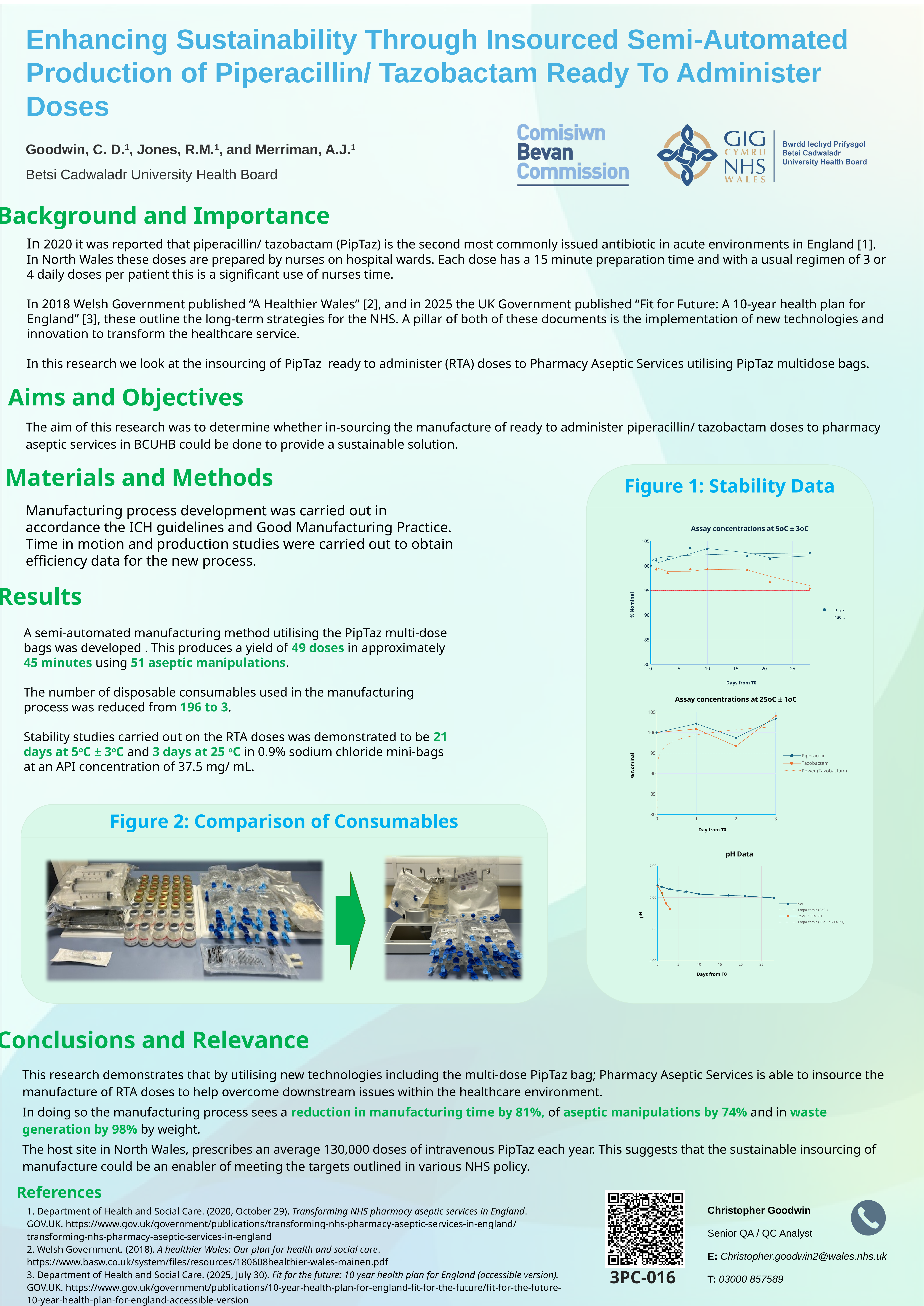
In the 'pH Data' chart, does the 5oC series rise or fall across the days from T0? fall In the 'Assay concentrations at 25oC ± 1oC' chart, how many days are plotted on the x axis? 4 In the 'Assay concentrations at 25oC ± 1oC' chart, how many entries does the legend list? 3 In the 'Assay concentrations at 5oC ± 3oC' chart, which series is higher at day 28, Piperacillin or Tazobactam? Piperacillin In the 'Assay concentrations at 5oC ± 3oC' chart, is the Piperacillin value at day 10 greater or less than 100? greater In the 'Assay concentrations at 5oC ± 3oC' chart, does the Tazobactam series rise or fall from day 0 to day 28? fall In the 'Assay concentrations at 5oC ± 3oC' chart, is the Tazobactam value at day 28 greater or less than 100? less In the 'Assay concentrations at 25oC ± 1oC' chart, is the Piperacillin value at day 3 greater or less than 100? greater In the 'pH Data' chart, how many entries does the legend list? 4 What is the x-axis label of the 'pH Data' chart? Days from T0 In Figure 1, what kind of chart is the 'Assay concentrations at 5oC ± 3oC' chart? line chart